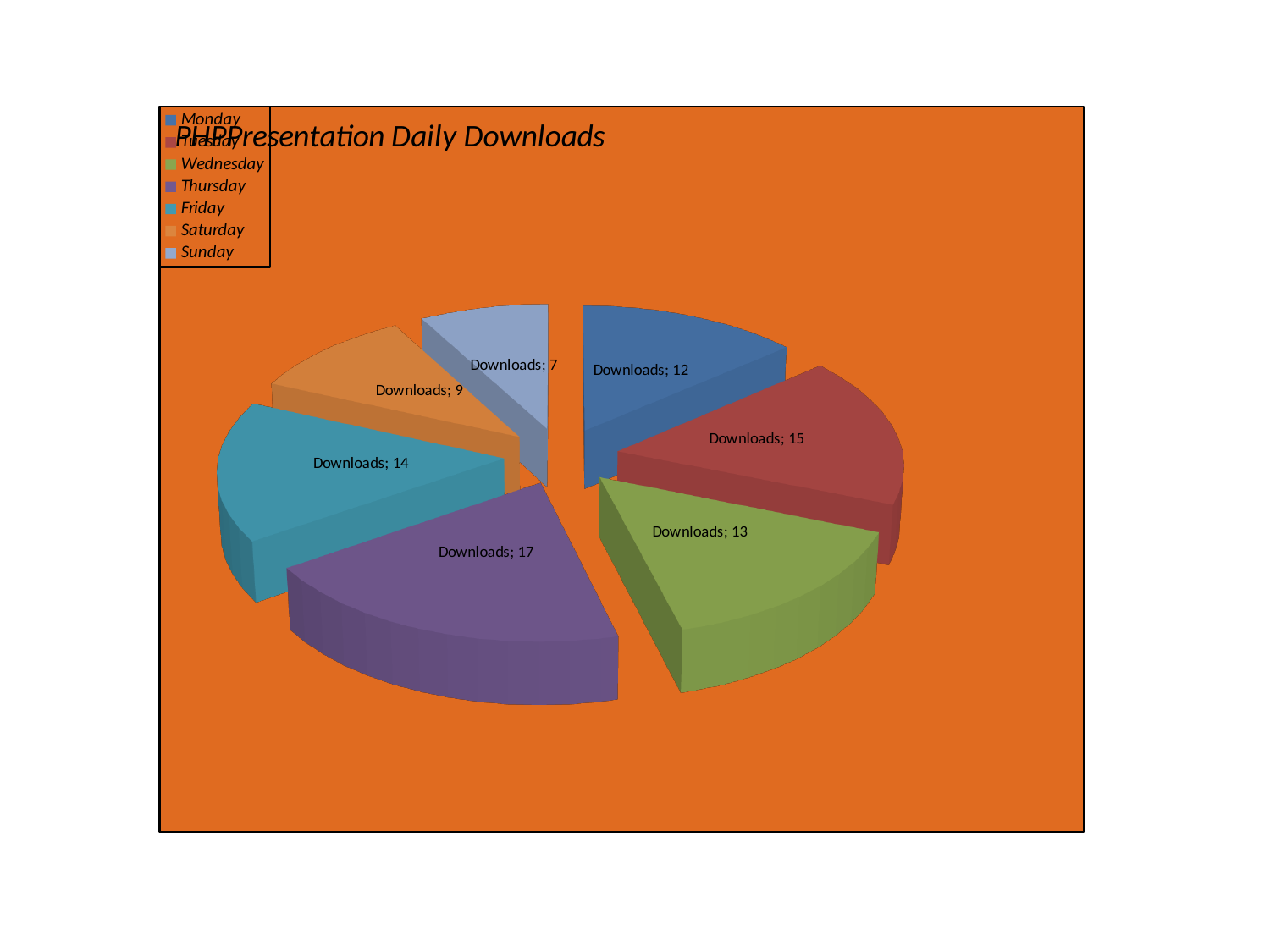
What is the Downloads value for Monday? 12 Which day has the lowest number of downloads? Sunday What is the title of the chart? PHPPresentation Daily Downloads Which has more downloads, Tuesday or Wednesday? Tuesday What is the Downloads value for Friday? 14 What is the Downloads value for Sunday? 7 What is the total number of downloads across all seven days? 87 What kind of chart is shown on the slide? Pie chart Which day has the highest number of downloads? Thursday What is the difference in downloads between Thursday and Sunday? 10 What is the Downloads value for Thursday? 17 How many categories does the legend list? 7